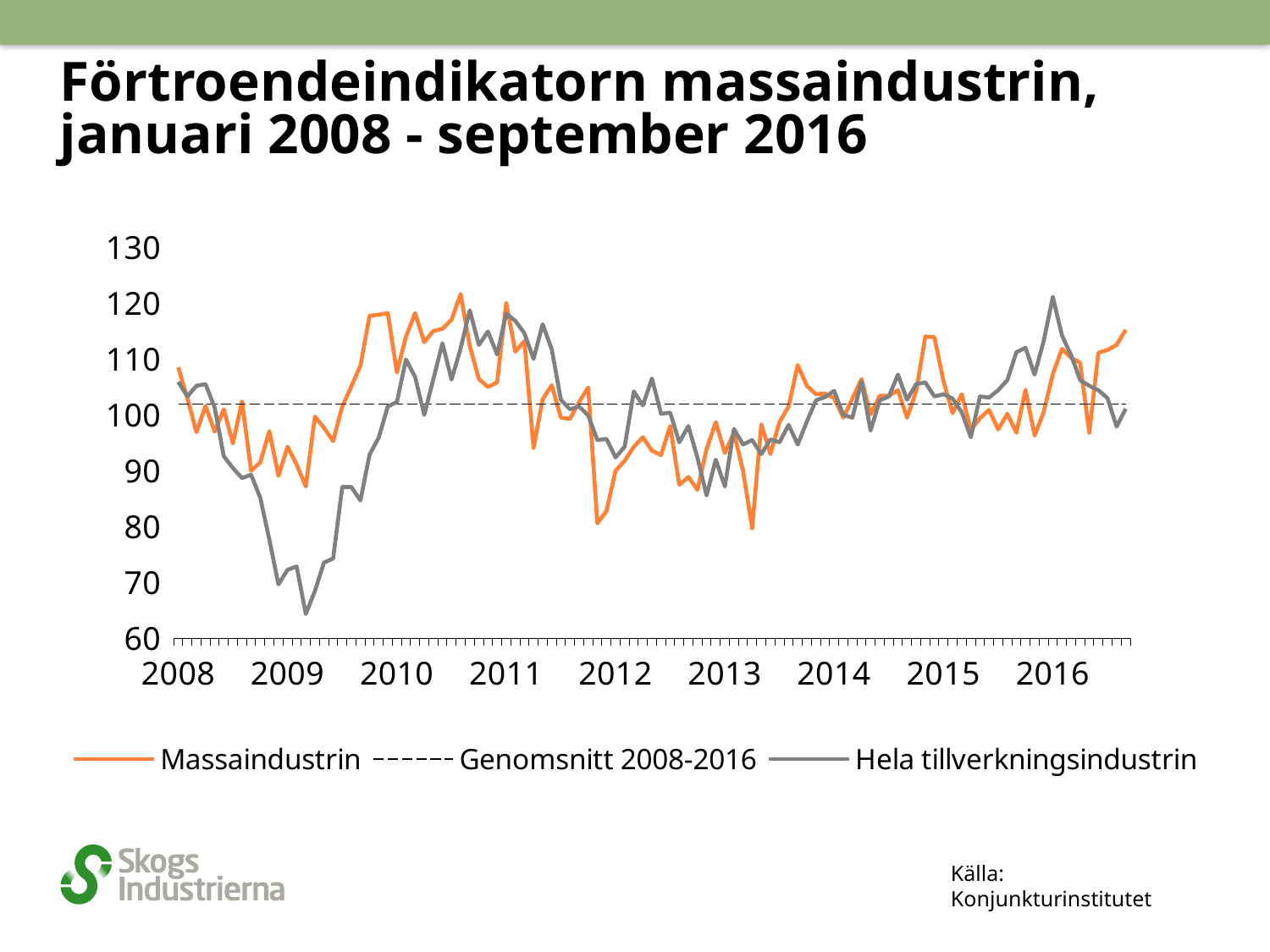
How many year labels are shown on the x axis? 9 Is the lowest value of Hela tillverkningsindustrin in 2009 greater or less than 70? less Does Hela tillverkningsindustrin rise or fall from the start of 2008 to the start of 2009? fall What is the title of the chart on the slide? Förtroendeindikatorn massaindustrin, januari 2008 - september 2016 Is the lowest value of Massaindustrin in 2013 greater or less than 90? less How many series does the legend list? 3 Is the Genomsnitt 2008-2016 line greater or less than 110? less What kind of chart is shown on the slide? Line chart What source is cited for the chart? Konjunkturinstitutet At the end of the series in 2016, which is higher: Massaindustrin or Hela tillverkningsindustrin? Massaindustrin Which series reaches the lowest value anywhere on the chart? Hela tillverkningsindustrin